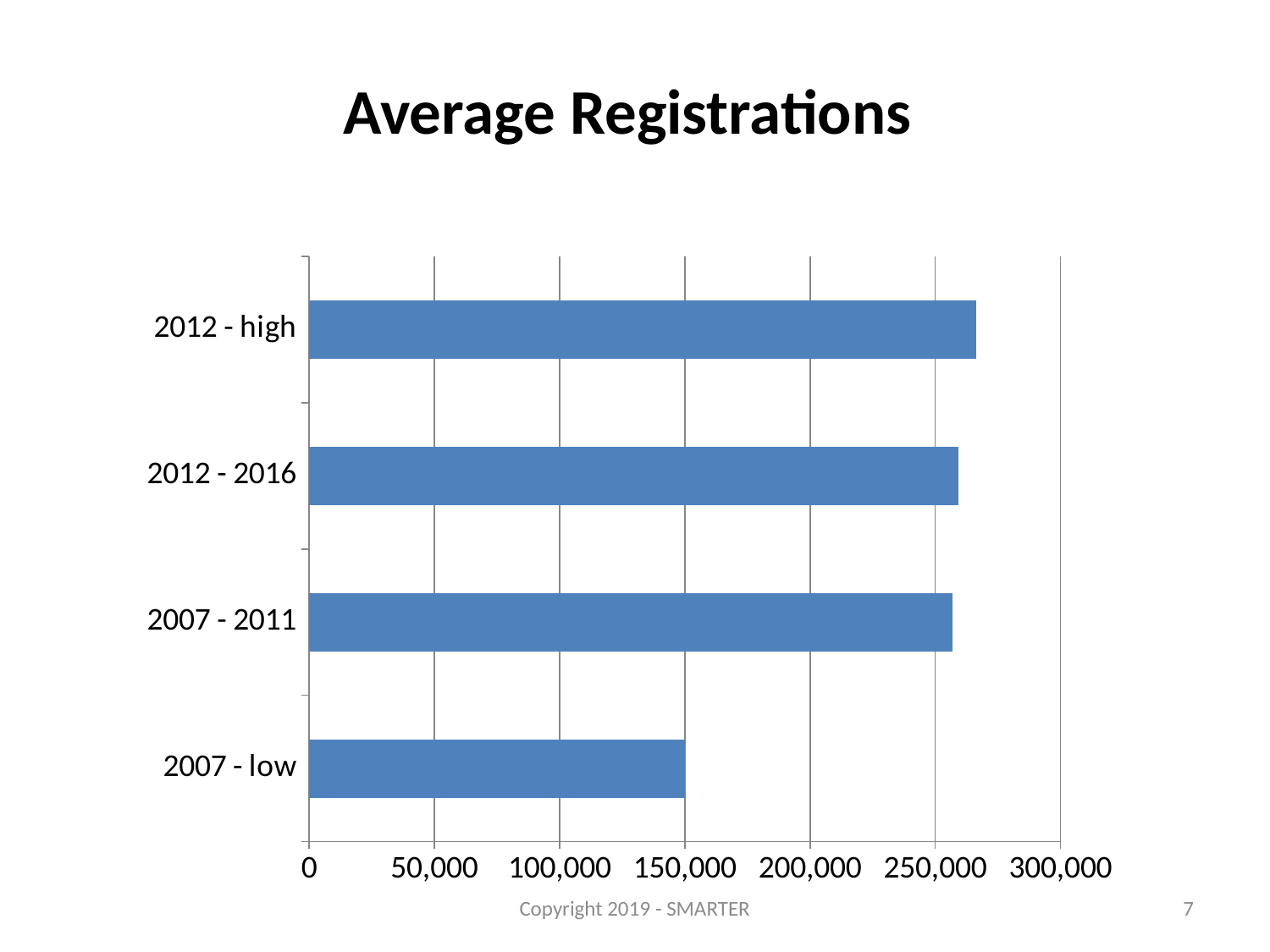
What is the value for 2007 - low? 150,000 What is the title of the chart? Average Registrations Is the value for 2007 - low greater or less than 200,000? less What type of chart is shown on the slide? bar chart Which category has the highest value? 2012 - high Is the value for 2007 - 2011 greater or less than 250,000? greater Is the value for 2012 - 2016 greater or less than 300,000? less How many categories are plotted in the chart? 4 Which category has the lowest value? 2007 - low Which is larger, the value for 2012 - high or the value for 2007 - 2011? 2012 - high What colour are the bars in the chart? blue